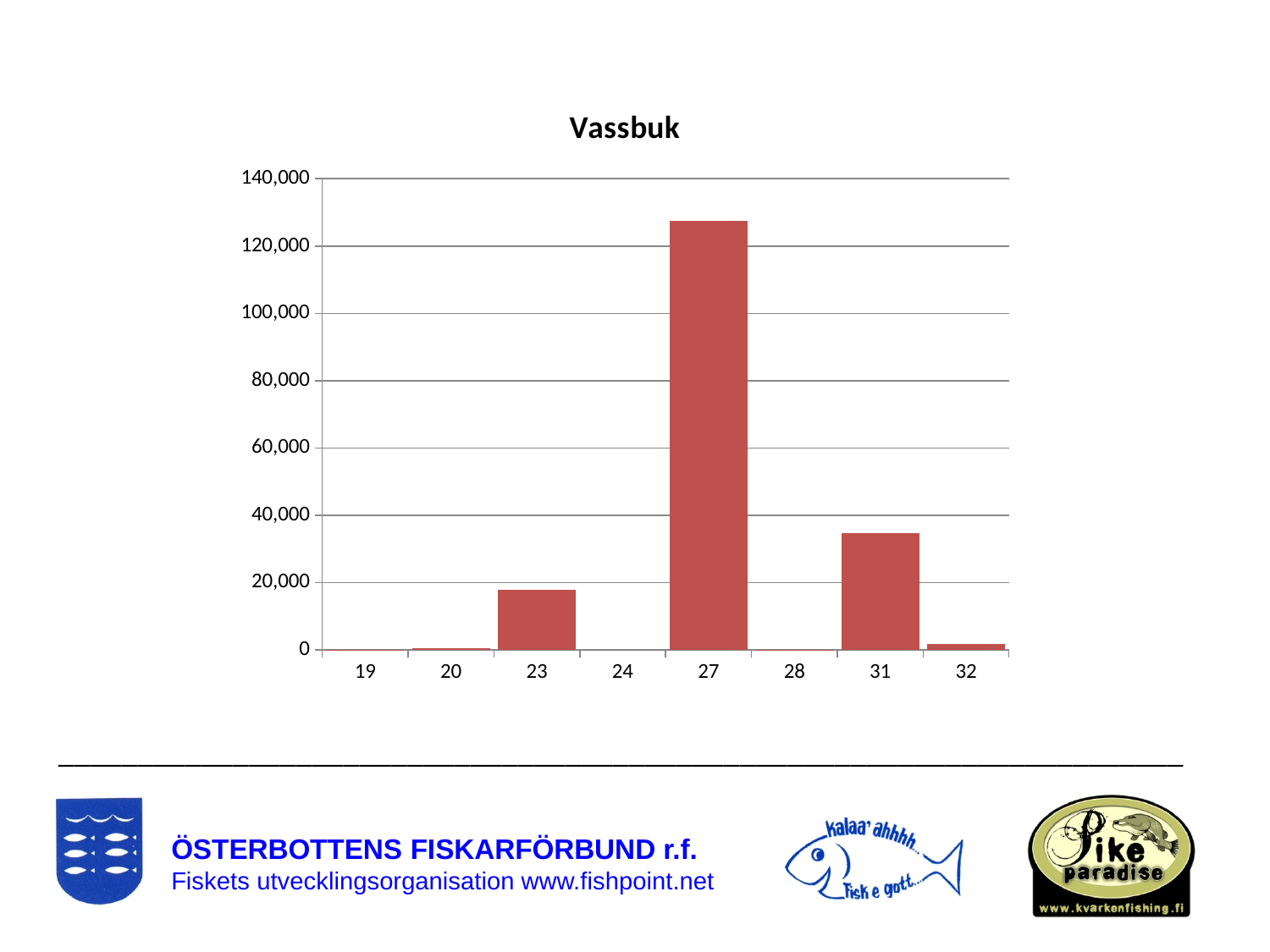
Is the value for category 31 greater or less than 40,000? less Is the value for category 23 greater or less than 20,000? less Is the value for category 27 greater or less than 120,000? greater Which is larger, the value for category 32 or the value for category 23? 23 What is the title of the chart? Vassbuk Which is larger, the value for category 23 or the value for category 31? 31 Which is larger, the value for category 27 or the value for category 31? 27 Which category has the highest value in the chart? 27 How many categories are shown on the x axis of the chart? 8 What kind of chart is shown on the slide? bar chart